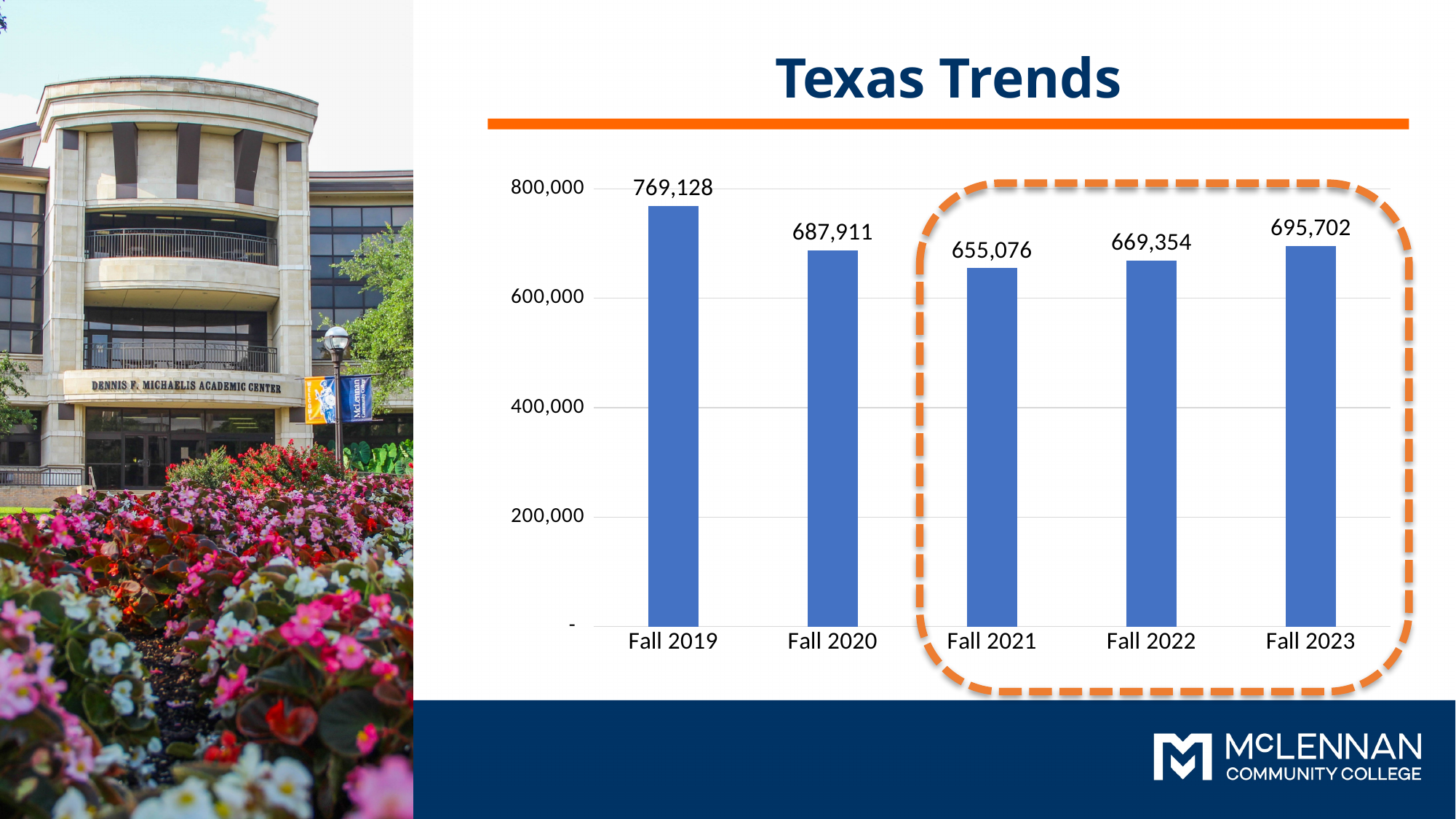
Is the value for Fall 2022 greater or less than 600,000? greater What is the difference between the Fall 2023 and Fall 2021 values? 40,626 Which term has the lowest value? Fall 2021 What is the value for Fall 2021? 655,076 Do the values rise or fall from Fall 2021 to Fall 2023? Rise What is the value for Fall 2023? 695,702 What kind of chart is shown on the slide? Bar chart Which term has the highest value? Fall 2019 How many terms are shown on the x axis? 5 What is the value for Fall 2019? 769,128 What is the difference between the Fall 2019 and Fall 2020 values? 81,217 Which is larger, the value for Fall 2020 or the value for Fall 2023? Fall 2023